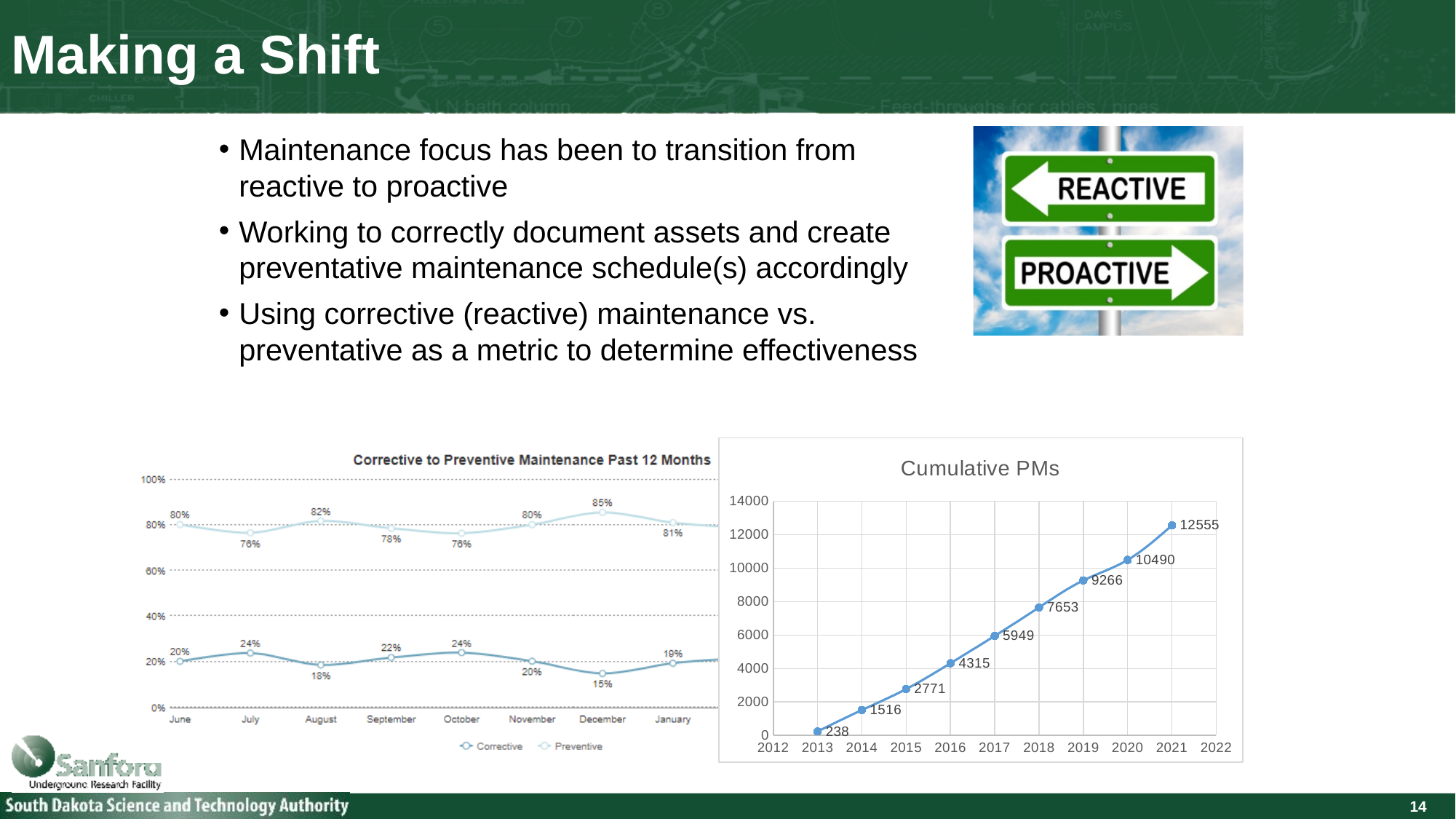
In the Cumulative PMs chart, what is the value for 2021? 12555 In the Corrective to Preventive Maintenance Past 12 Months chart, what is the Corrective value for August? 18% In the Corrective to Preventive Maintenance Past 12 Months chart, what is the Preventive value for December? 85% In the Cumulative PMs chart, what is the value for 2017? 5949 In the Corrective to Preventive Maintenance Past 12 Months chart, how many series does the legend list? 2 What kind of chart is the Cumulative PMs chart? line chart In the Cumulative PMs chart, what is the difference between the 2021 and 2020 values? 2065 In the Corrective to Preventive Maintenance Past 12 Months chart, which is larger, the Corrective value for July or the Corrective value for November? July In the Cumulative PMs chart, how many data points are plotted? 9 In the Cumulative PMs chart, what is the value for 2013? 238 In the Corrective to Preventive Maintenance Past 12 Months chart, which month has the lowest Corrective value? December In the Cumulative PMs chart, do the values rise or fall from 2013 to 2021? rise